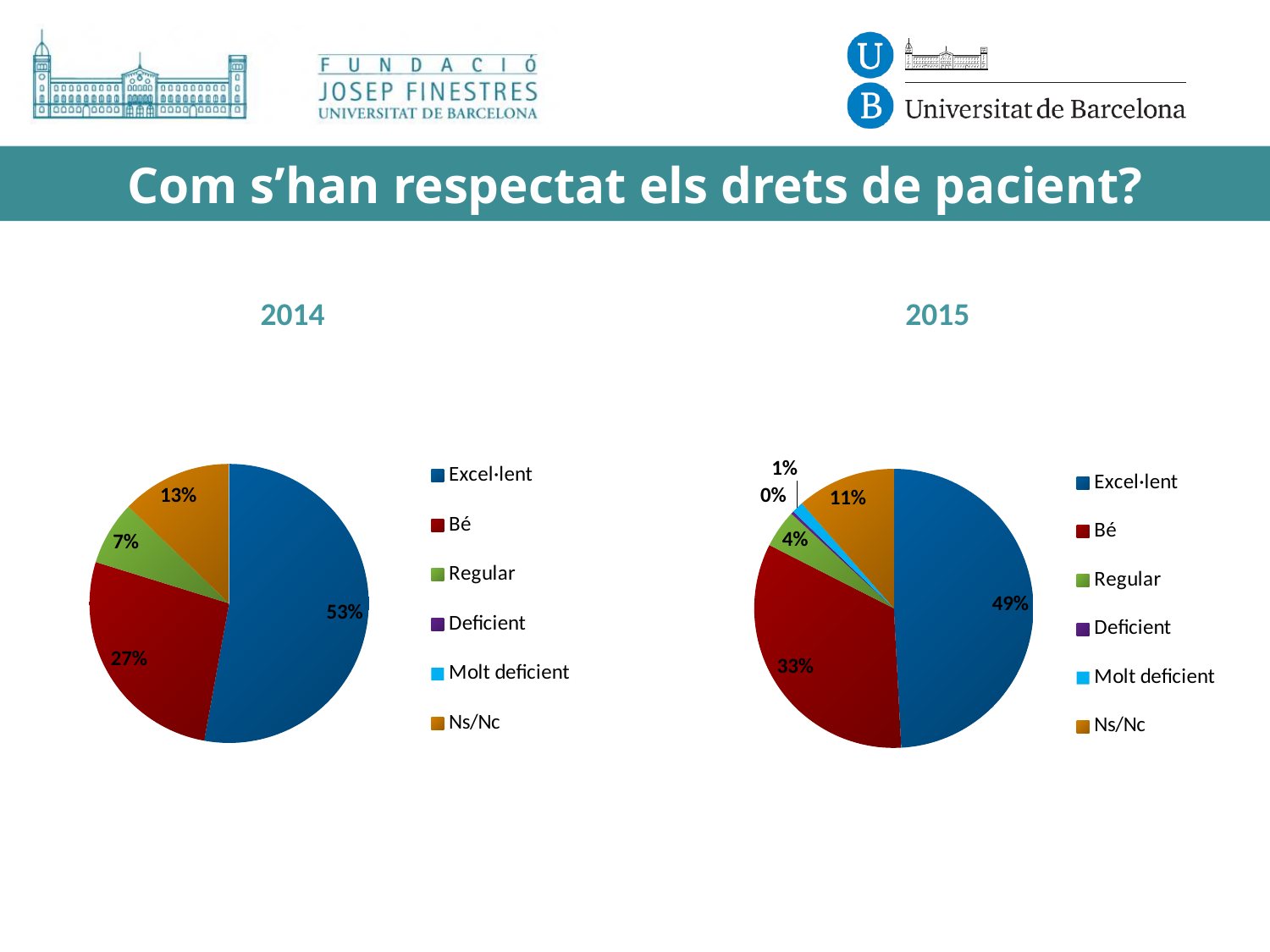
In the 2015 pie chart, which category has the largest slice? Excel·lent In the 2014 pie chart, which labelled category has the smallest slice? Regular In the 2014 pie chart, what share is labelled for Excel·lent? 53% What type of chart is used for the 2015 data? Pie chart In the 2015 pie chart, what share is labelled for Regular? 4% In the 2015 pie chart, what share is labelled for Ns/Nc? 11% In the 2014 pie chart, what share is labelled for Ns/Nc? 13% In the 2015 pie chart, what share is labelled for Excel·lent? 49% Is the Bé share larger in the 2014 chart or the 2015 chart? 2015 In the 2014 pie chart, what share is labelled for Bé? 27% What is the difference between the Excel·lent share in 2014 and in 2015? 4% How many entries does the legend of the 2014 pie chart list? 6